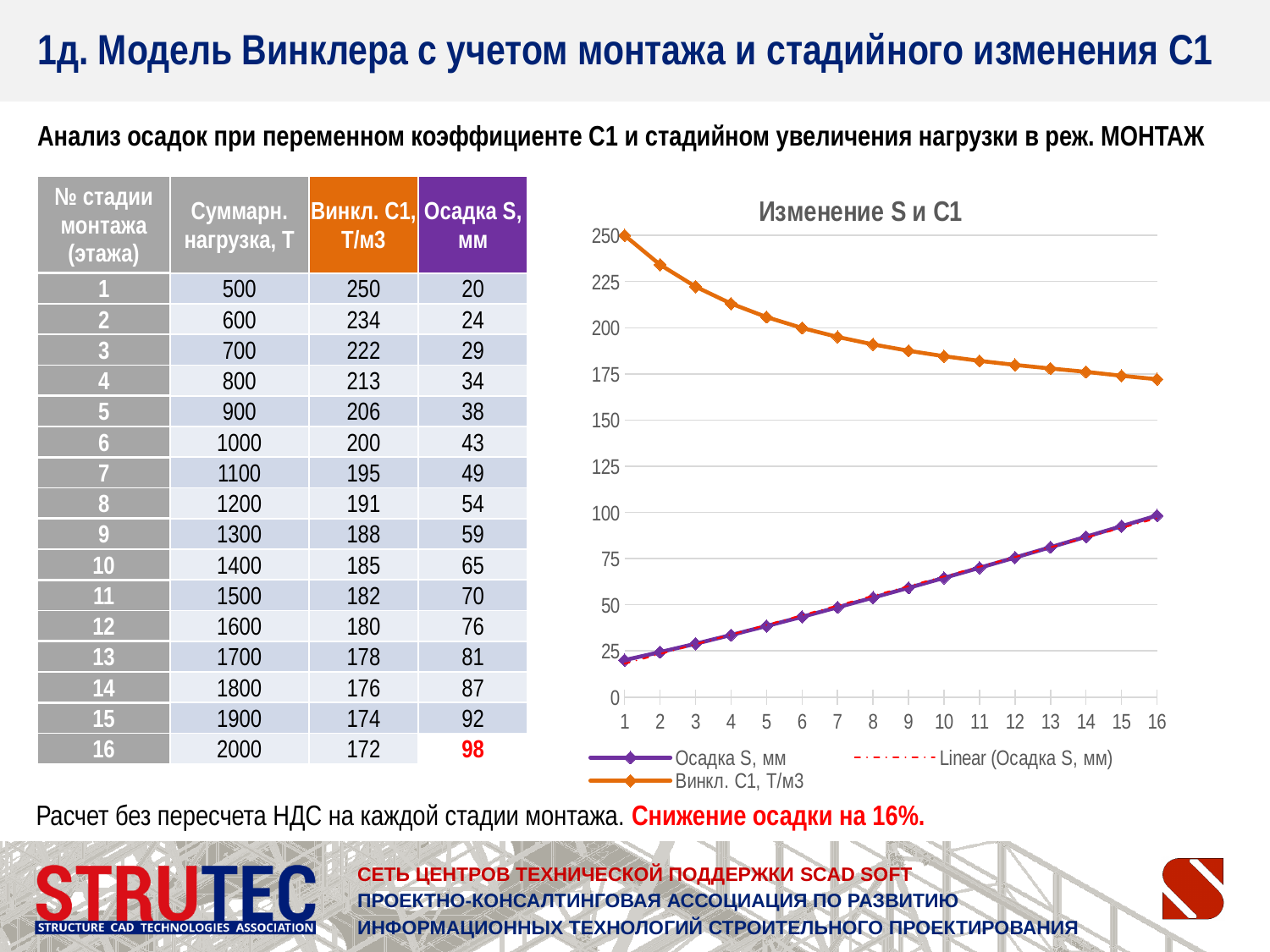
Does the Винкл. C1, Т/м3 series rise or fall as the stage number increases? fall What is the value of Винкл. C1, Т/м3 at stage 6? 200 Is the value of Осадка S, мм at stage 16 greater or less than 75? greater Is the value of Винкл. C1, Т/м3 at stage 10 greater or less than 200? less What is the title of the chart? Изменение S и C1 How many entries does the chart legend list? 3 By how much does Винкл. C1, Т/м3 decrease from stage 1 to stage 6? 50 How many stages (points) are plotted along the x axis of the chart? 16 What kind of chart is shown on the slide? line chart Does the Осадка S, мм series rise or fall as the stage number increases? rise What is the value of Осадка S, мм at stage 16? 98 What is the value of Винкл. C1, Т/м3 at stage 1? 250